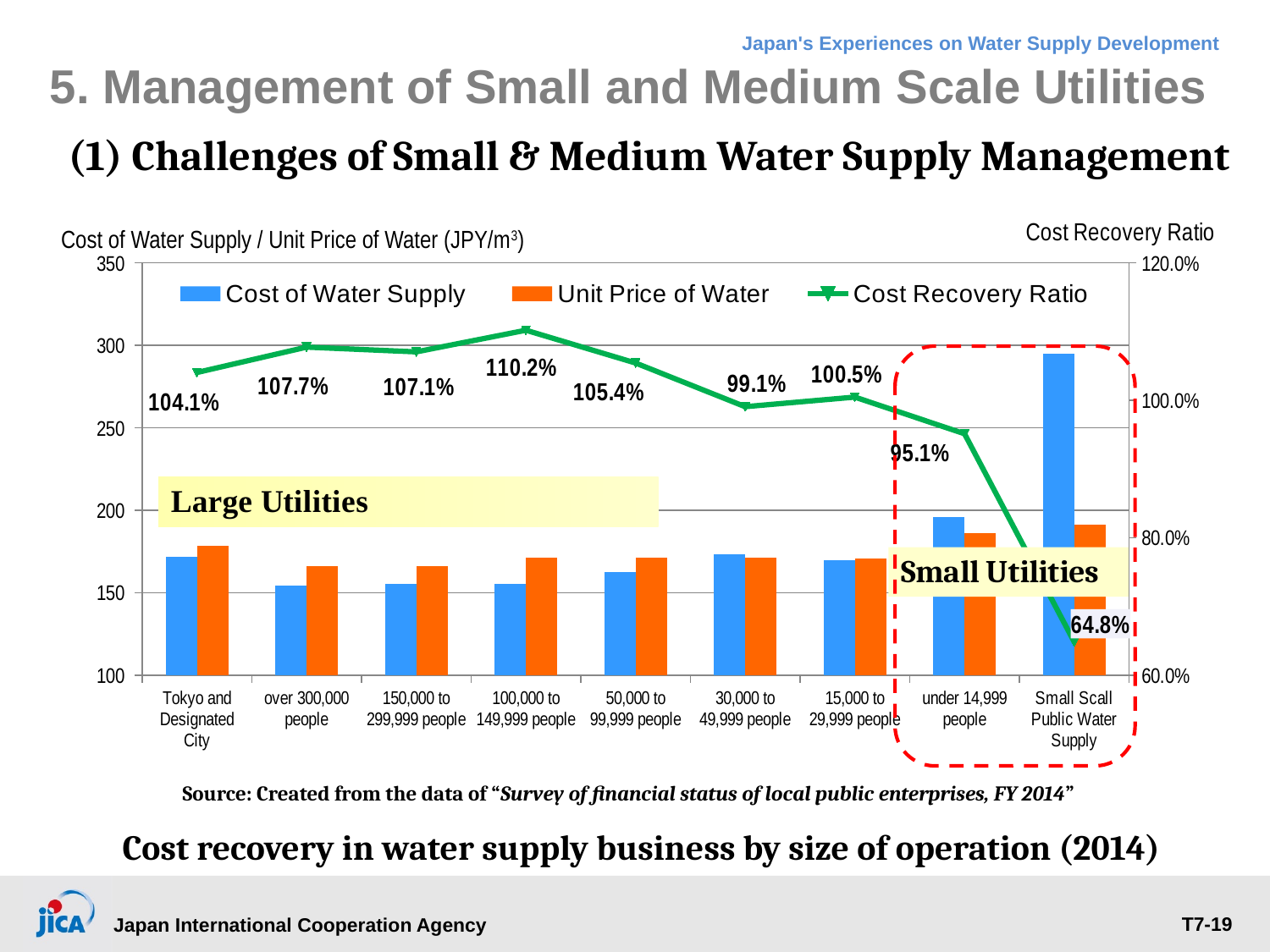
What is the Cost Recovery Ratio for 'Tokyo and Designated City'? 104.1% Which category has the highest Cost Recovery Ratio? 100,000 to 149,999 people What is the Cost Recovery Ratio for 'Small Scall Public Water Supply'? 64.8% What is the Cost Recovery Ratio for the '100,000 to 149,999 people' category? 110.2% What is the difference in Cost Recovery Ratio between '100,000 to 149,999 people' and 'Small Scall Public Water Supply'? 45.4 percentage points Is the Cost of Water Supply for 'Tokyo and Designated City' greater or less than 200? less How many series does the legend list? 3 Which has a higher Cost Recovery Ratio: '30,000 to 49,999 people' or '15,000 to 29,999 people'? 15,000 to 29,999 people Is the Cost of Water Supply for 'Small Scall Public Water Supply' greater or less than 250? greater Which category has the lowest Cost Recovery Ratio? Small Scall Public Water Supply Does the Cost Recovery Ratio rise or fall from '15,000 to 29,999 people' to 'Small Scall Public Water Supply'? fall How many categories are shown on the x axis? 9